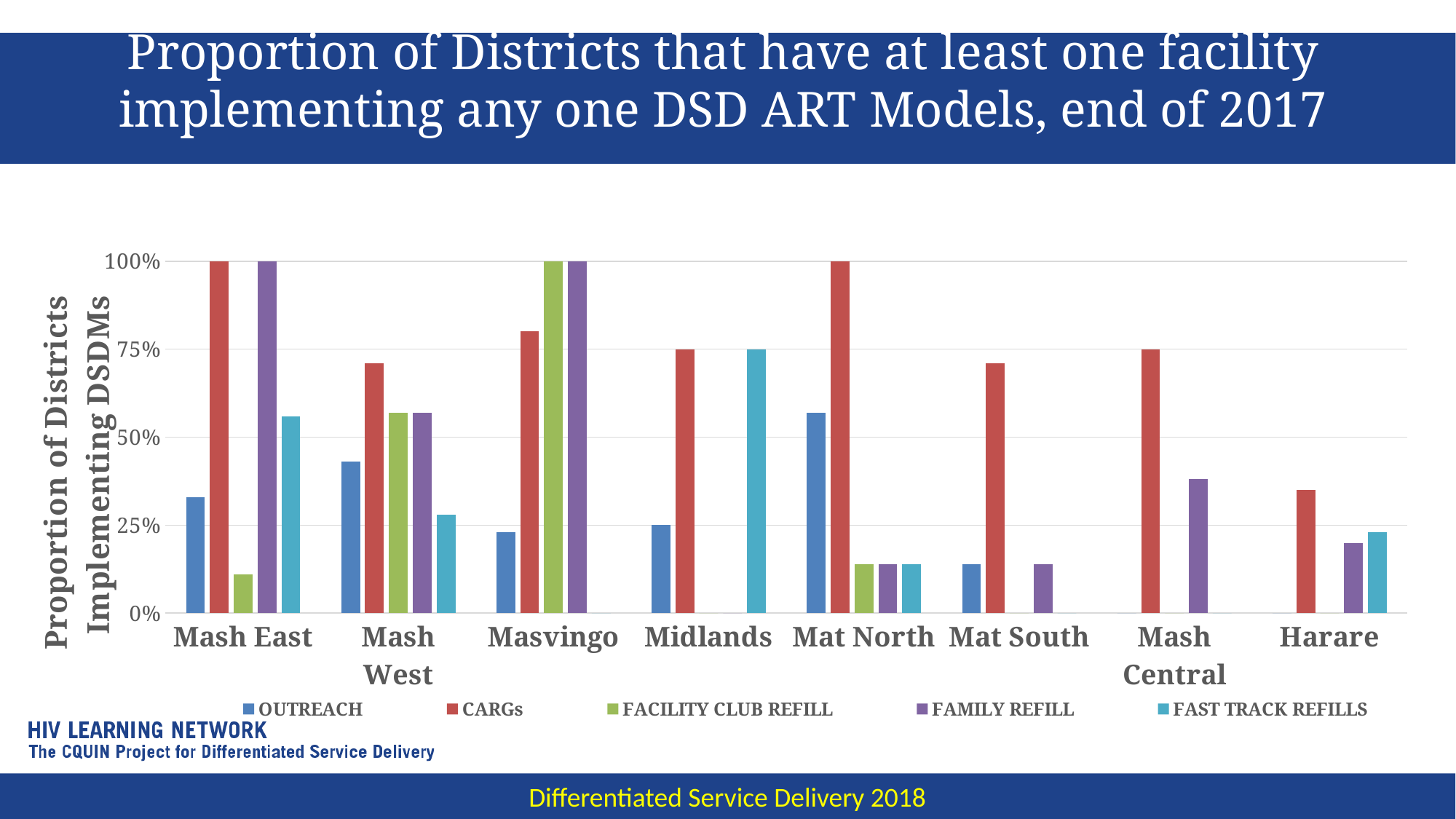
Is the value for OUTREACH in Mash West greater or less than 50%? less How many provinces are shown on the x axis? 8 What is the value for FAST TRACK REFILLS in Midlands? 75% Which is larger in Mash East: OUTREACH or FAST TRACK REFILLS? FAST TRACK REFILLS What is the value for CARGs in Mash Central? 75% What is the value for FAMILY REFILL in Masvingo? 100% Is the value for CARGs in Masvingo greater or less than 75%? greater What kind of chart is shown on the slide? Bar chart What is the value for CARGs in Mash East? 100% How many series does the legend list? 5 What is the difference between the CARGs value for Mat North and the CARGs value for Midlands? 25% Which series has the highest value in Harare? CARGs